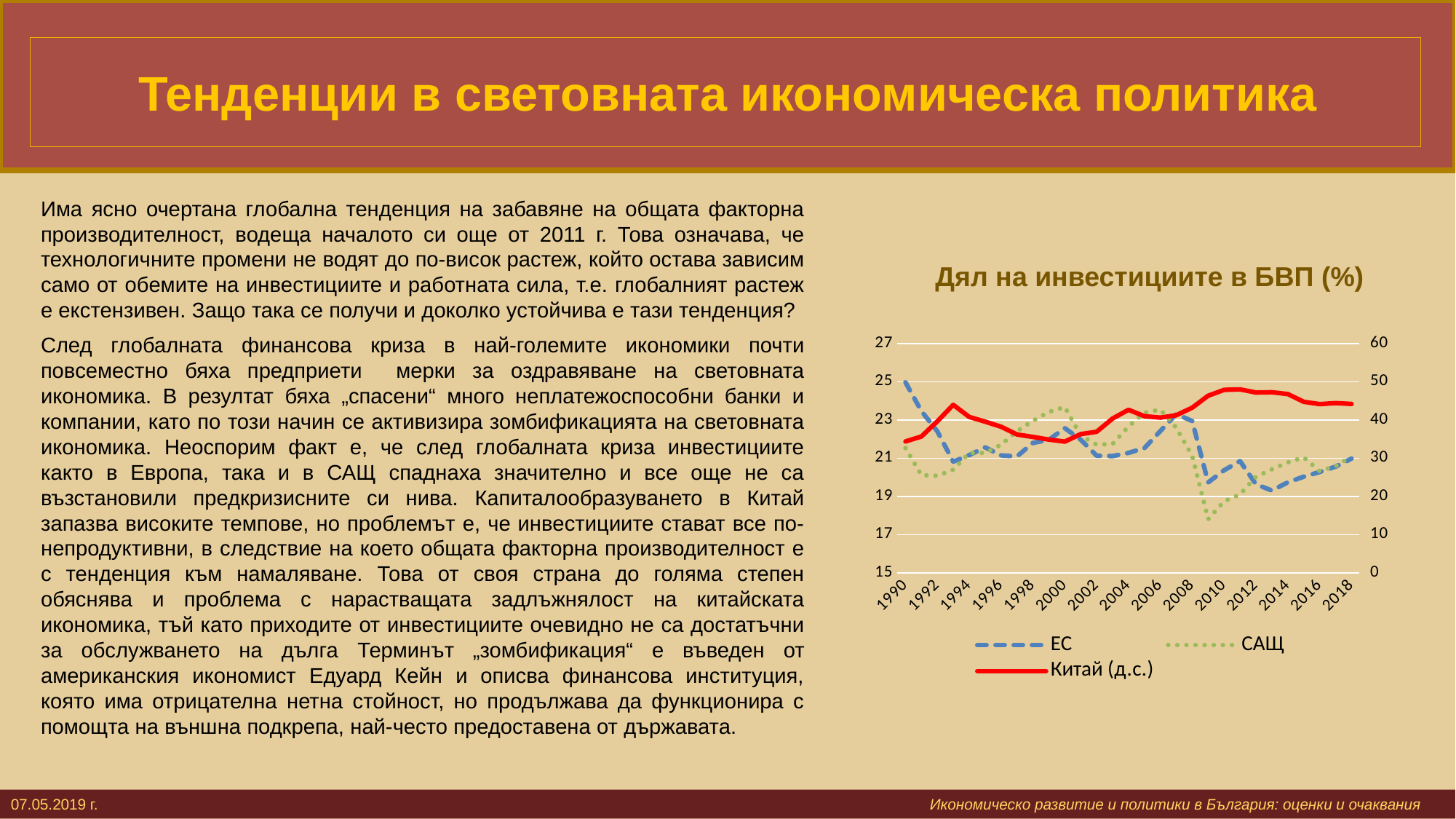
How many year labels are shown on the x axis? 15 Is the value for ЕС in 2010 greater or less than 21? less Is the value for Китай (д.с.) in 2012 greater or less than 40 on the right axis? greater What is the title of the chart? Дял на инвестициите в БВП (%) Which is larger in 1990, the value for ЕС or the value for САЩ? ЕС Which series is plotted on the secondary (right-hand) axis according to the legend? Китай (д.с.) Does the value for Китай (д.с.) rise or fall overall from 1990 to 2018? rise Is the value for ЕС in 2008 greater or less than 21? greater How many series does the chart legend list? 3 What kind of chart is shown on the slide? line chart Does the value for ЕС rise or fall overall from 1990 to 2018? fall